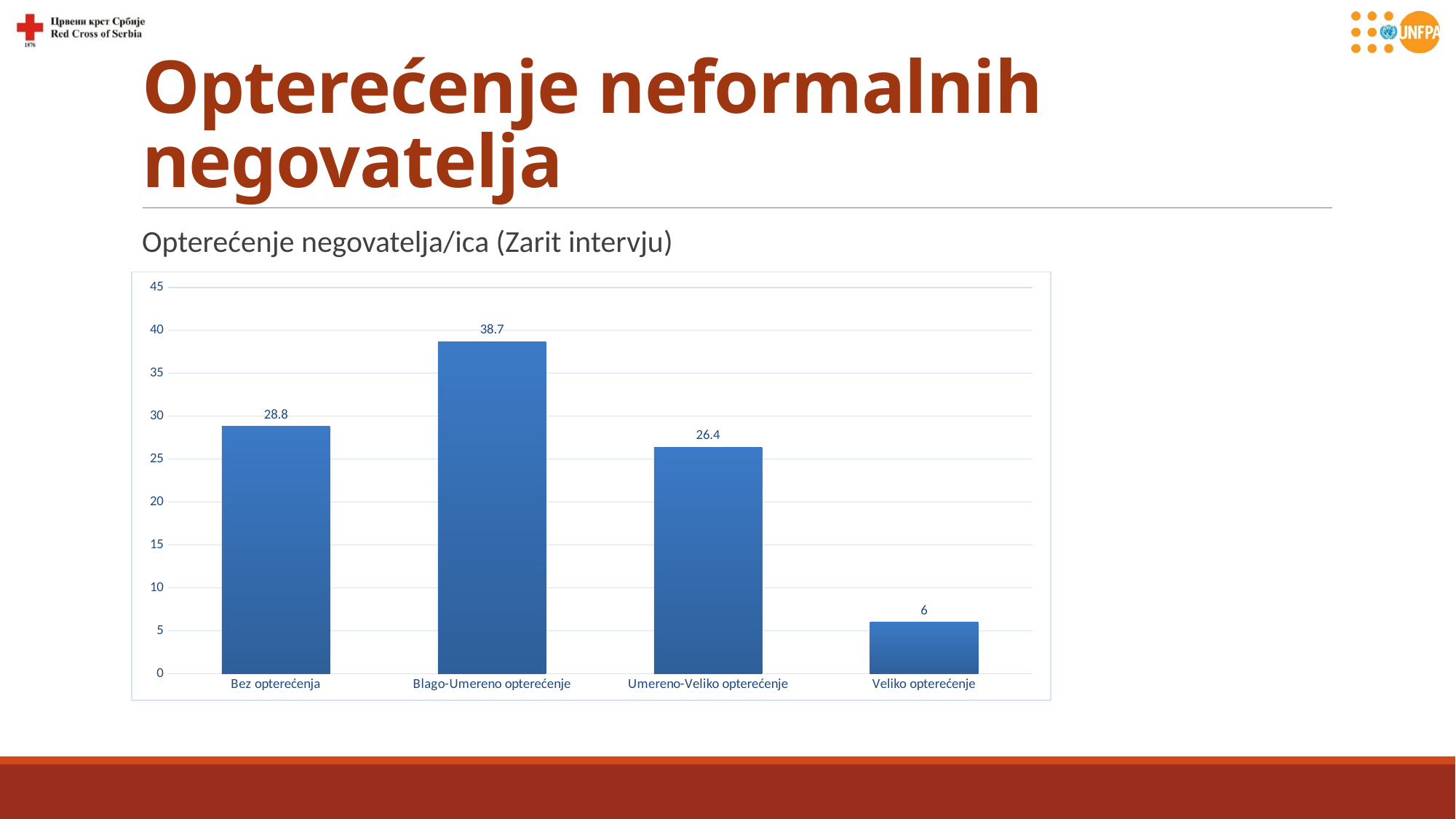
Which category has the lowest value? Veliko opterećenje Is the value for Veliko opterećenje greater or less than 10? less How many categories are shown on the x axis? 4 What is the difference between the values for Blago-Umereno opterećenje and Bez opterećenja? 9.9 What kind of chart is shown on the slide? bar chart What is the value for Bez opterećenja? 28.8 What is the value for Veliko opterećenje? 6 What is the value for Umereno-Veliko opterećenje? 26.4 Which is larger, the value for Bez opterećenja or the value for Umereno-Veliko opterećenje? Bez opterećenja What is the value for Blago-Umereno opterećenje? 38.7 What is the heading shown directly above the chart? Opterećenje negovatelja/ica (Zarit intervju) Which category has the highest value? Blago-Umereno opterećenje